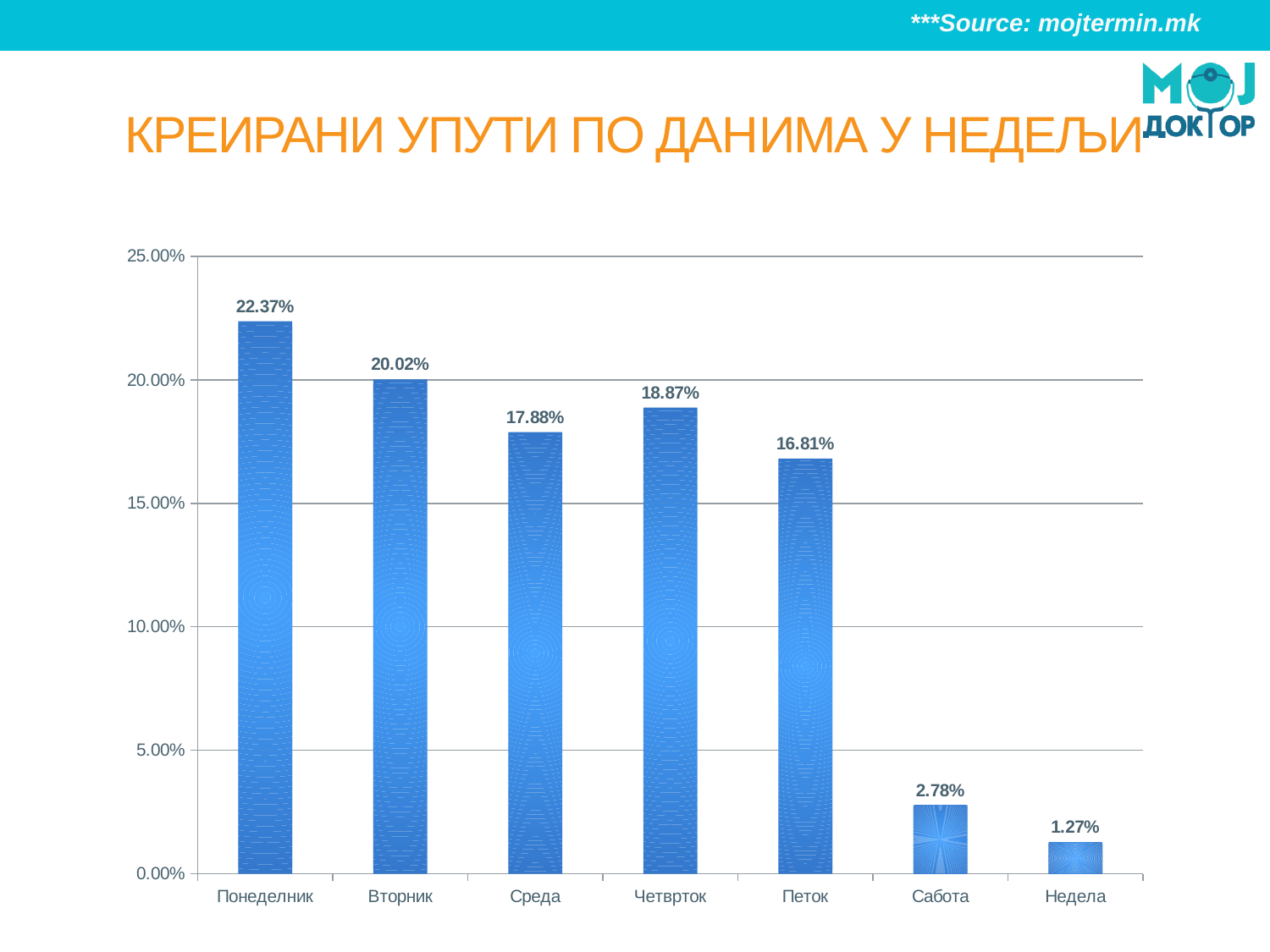
What is the difference between the values for Понеделник and Вторник? 2.35% Which is larger, the value for Среда or the value for Петок? Среда What kind of chart is shown on the slide? bar chart Is the value for Вторник greater or less than 15.00%? greater What is the value for Понеделник? 22.37% What is the title of the chart on the slide? КРЕИРАНИ УПУТИ ПО ДАНИМА У НЕДЕЉИ Which day has the lowest value? Недела How many days are shown on the x axis? 7 What is the value for Сабота? 2.78% What is the value for Четврток? 18.87% What is the difference between the values for Сабота and Недела? 1.51% Which day has the highest value? Понеделник